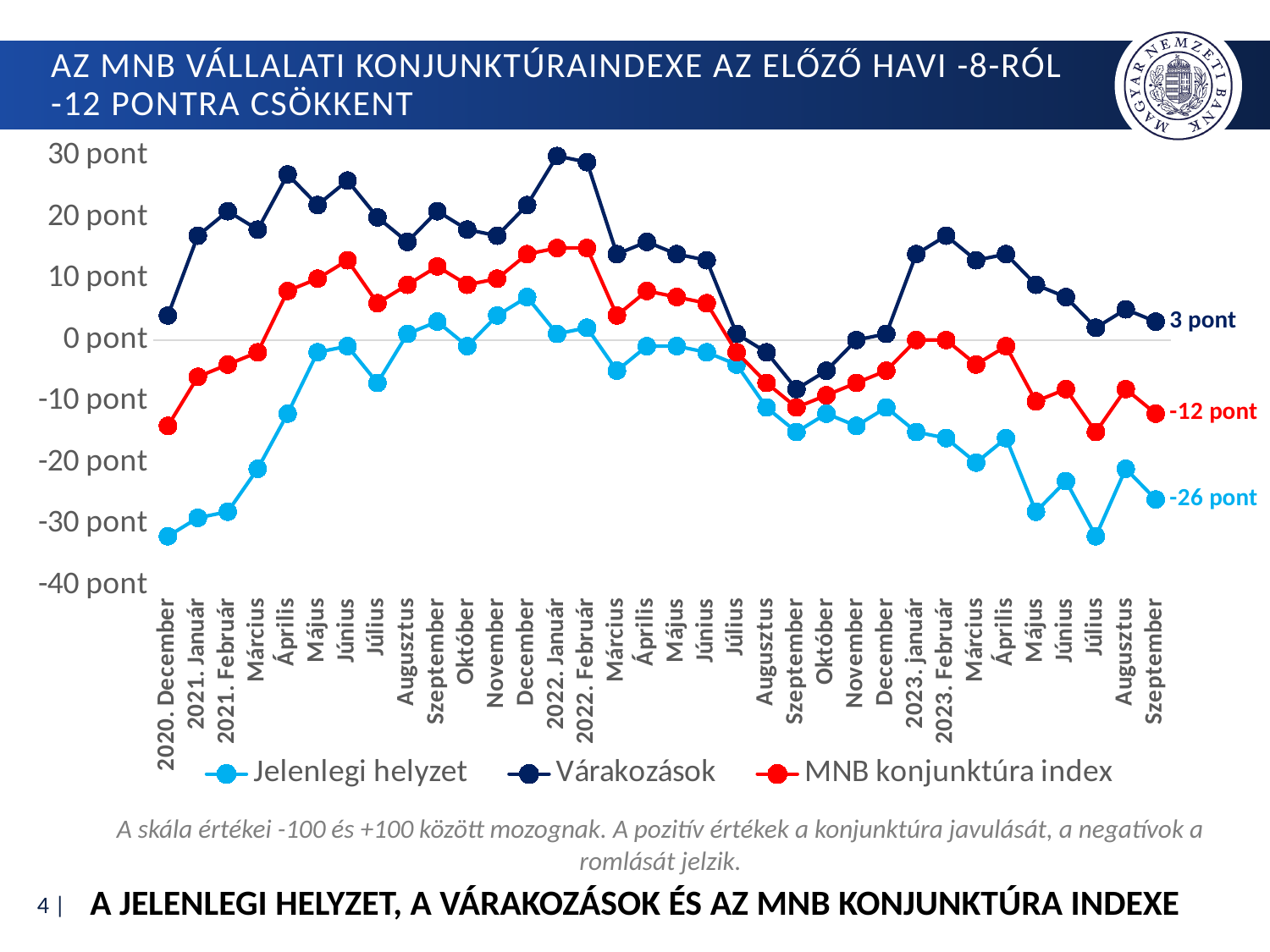
Is the value of Várakozások in 2022. Január greater or less than 20 pont? greater How many monthly data points does each series have on the x axis? 34 What kind of chart is shown on the slide? Line chart Is the value of Jelenlegi helyzet in 2020. December greater or less than -20 pont? less What is the value of the MNB konjunktúra index at the last point (Szeptember 2023)? -12 pont Which series is drawn in red? MNB konjunktúra index What is the value of the Jelenlegi helyzet series at the last point (Szeptember 2023)? -26 pont Does the MNB konjunktúra index rise or fall from Augusztus 2023 to Szeptember 2023? Fall How many series does the legend list? 3 What is the value of the Várakozások series at the last point (Szeptember 2023)? 3 pont At the last point (Szeptember 2023), which series has the higher value: Jelenlegi helyzet or Várakozások? Várakozások What is the difference between the final Várakozások value (3 pont) and the final MNB konjunktúra index value (-12 pont)? 15 pont